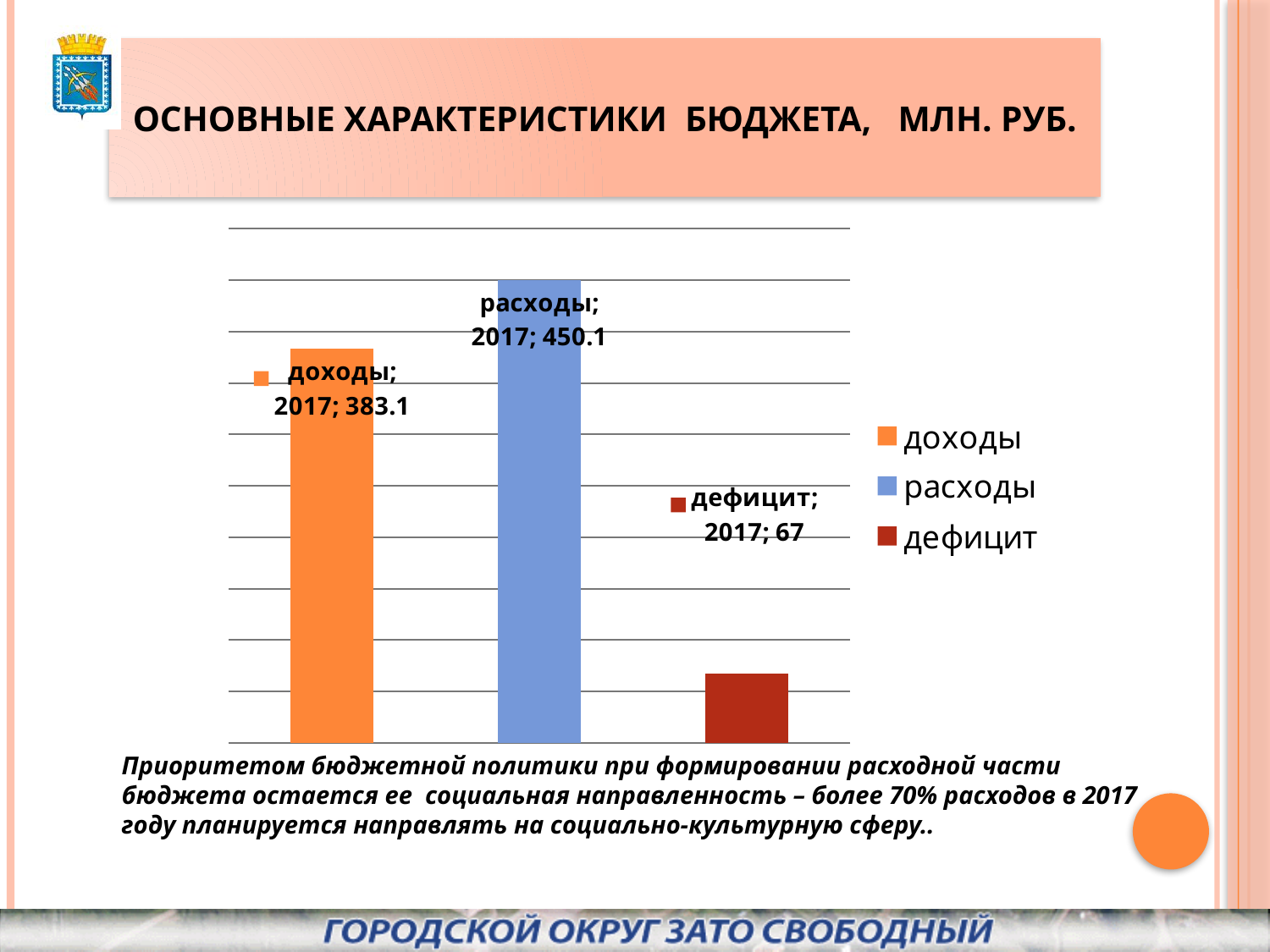
Which series has the lowest value on the chart? дефицит What is the difference between доходы and дефицит for 2017? 316.1 Which series has the highest value on the chart? расходы What is the difference between расходы and доходы for 2017? 67 What colour is the bar for дефицит? dark red What kind of chart is shown on the slide? bar chart What is the value for доходы in 2017? 383.1 What is the value for расходы in 2017? 450.1 How many series does the legend list? 3 What is the value for дефицит in 2017? 67 Which is larger, доходы or расходы? расходы How many bars are plotted on the chart? 3